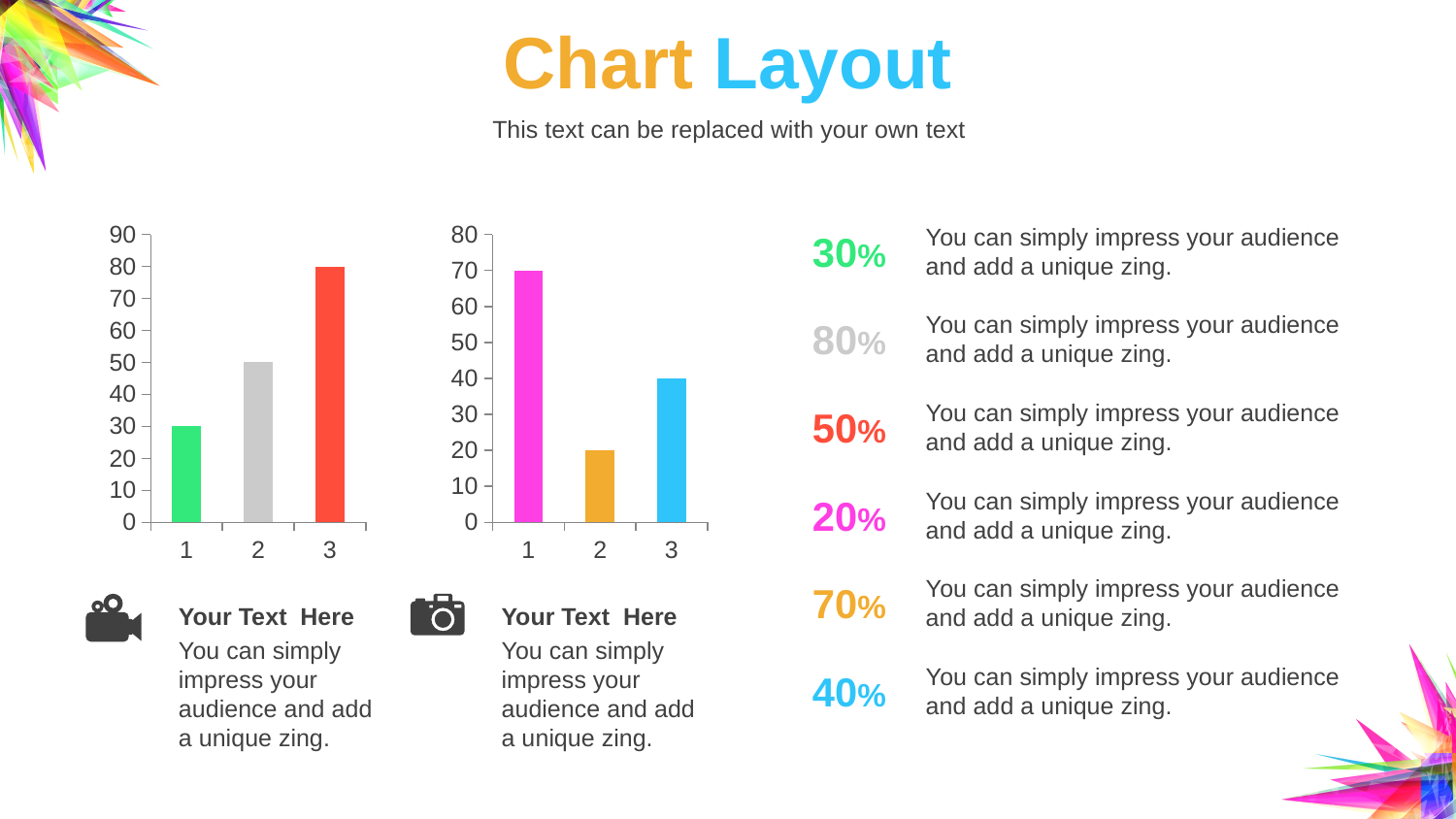
In the left chart, what is the value for category 3? 80 In the left chart, which category has the highest value? 3 What kind of chart is the right chart? bar chart In the left chart, what is the difference between the values for category 3 and category 2? 30 In the right chart, which is larger, the value for category 3 or the value for category 2? category 3 In the right chart, which category has the lowest value? 2 In the right chart, what is the value for category 2? 20 In the left chart, what is the value for category 1? 30 In the right chart, what is the value for category 1? 70 In the left chart, do the values rise or fall from category 1 to category 3? rise How many categories are shown on the x axis of the left chart? 3 In the right chart, what is the difference between the values for category 1 and category 3? 30